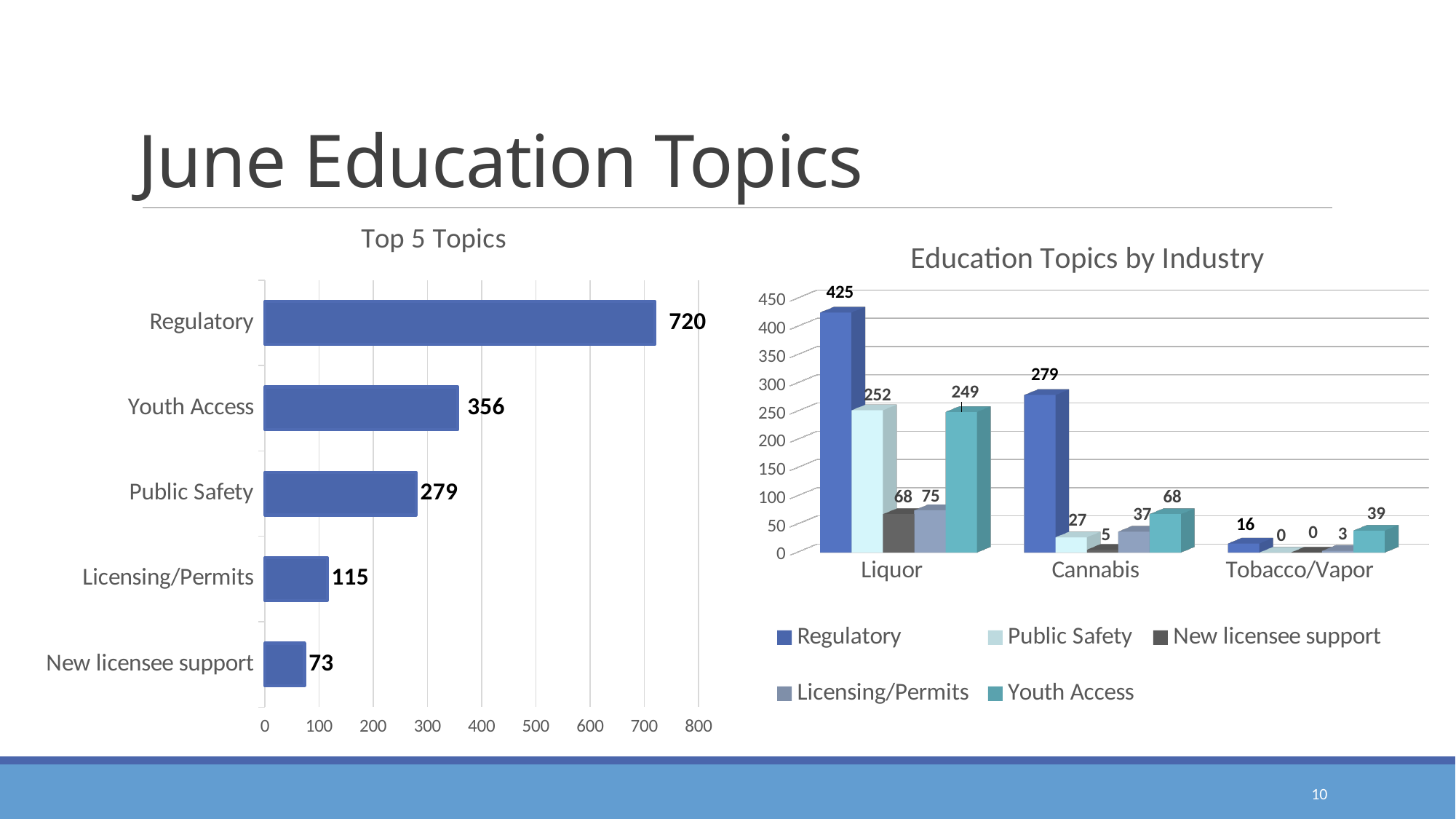
In the 'Education Topics by Industry' chart, what is the difference between the Regulatory values for Liquor and Cannabis? 146 In the 'Top 5 Topics' chart, which topic has the lowest value? New licensee support In the 'Top 5 Topics' chart, which topic has the highest value? Regulatory In the 'Education Topics by Industry' chart, what is the Regulatory value for Cannabis? 279 In the 'Top 5 Topics' chart, what is the difference between Regulatory and Youth Access? 364 In the 'Top 5 Topics' chart, how many topics are shown? 5 In the 'Education Topics by Industry' chart, which is larger for Liquor: Public Safety or Youth Access? Public Safety In the 'Education Topics by Industry' chart, what is the Youth Access value for Tobacco/Vapor? 39 In the 'Top 5 Topics' chart, what is the value for Youth Access? 356 In the 'Education Topics by Industry' chart, which industry has the highest Regulatory value? Liquor In the 'Education Topics by Industry' chart, how many series does the legend list? 5 What kind of chart is the 'Top 5 Topics' chart? Bar chart